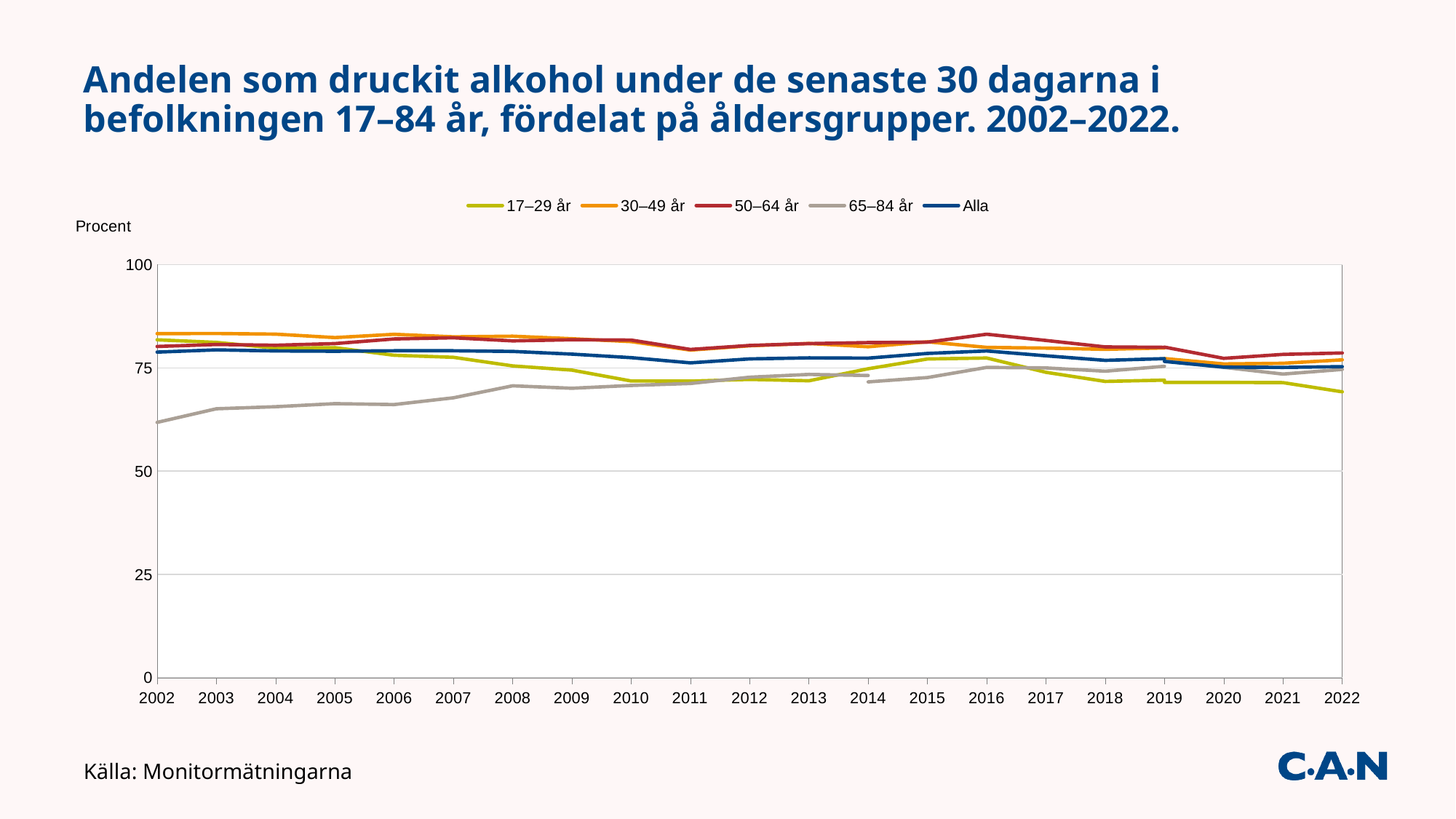
Which age group has the lowest value in 2002? 65–84 år How many series does the legend list? 5 What label is shown on the y axis? Procent Is the value for 17–29 år in 2022 greater or less than 75? less What kind of chart is shown on the slide? line chart Which age group has the highest value in 2002? 30–49 år In 2002, which is larger: the value for 30–49 år or the value for 65–84 år? 30–49 år Does the line for 65–84 år generally rise or fall from 2002 to 2022? rise Is the value for 30–49 år in 2002 greater or less than 75? greater How many years are shown along the x axis? 21 Is the value for 65–84 år in 2002 greater or less than 75? less Which age group has the lowest value in 2022? 17–29 år